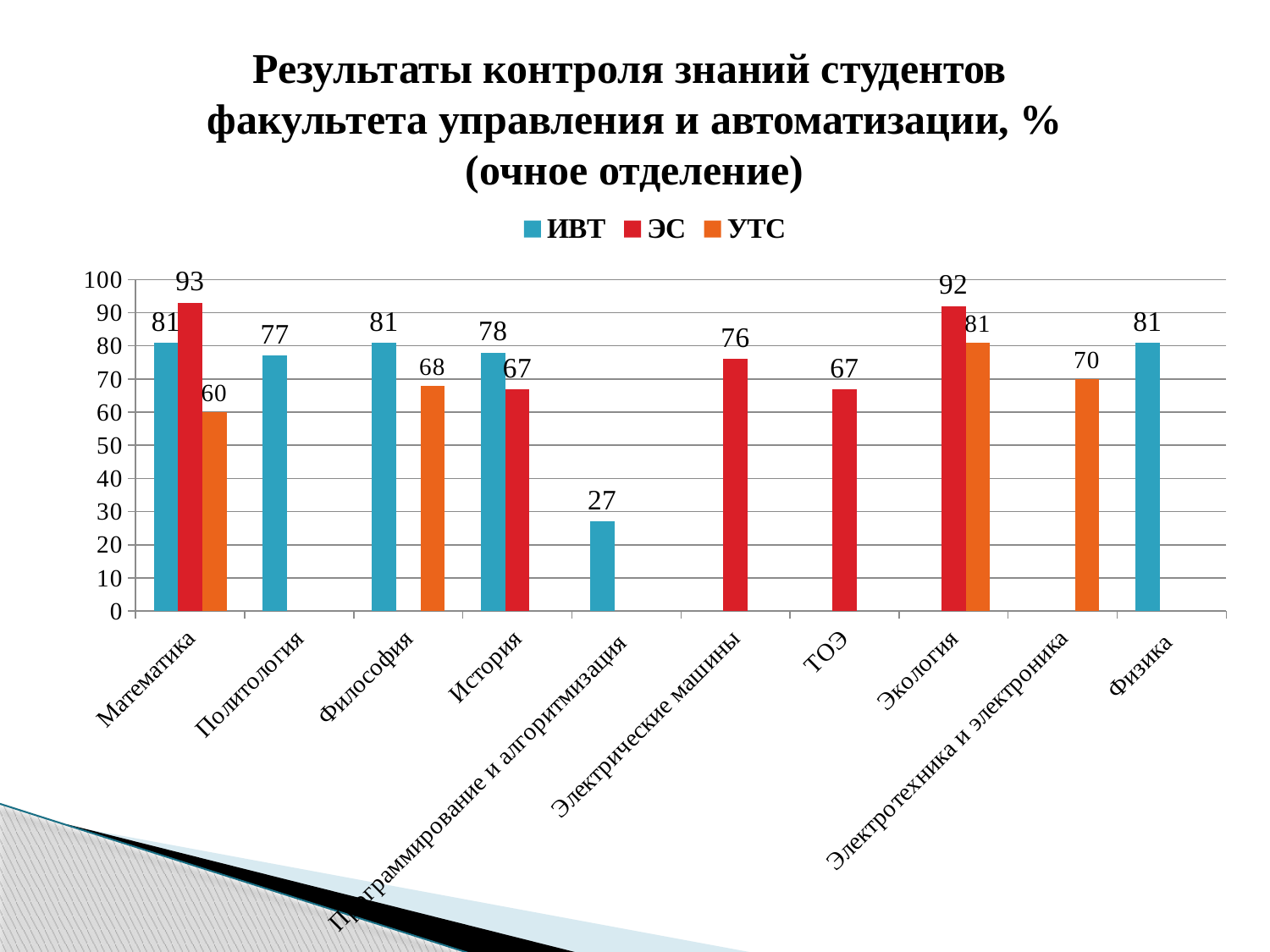
What is the value for ЭС in Экология? 92 How many series does the legend list? 3 What is the value for УТС in Философия? 68 How many categories are shown on the x axis? 10 Which category has the lowest ИВТ value? Программирование и алгоритмизация What is the value for ИВТ in Программирование и алгоритмизация? 27 What is the value for ЭС in Математика? 93 What kind of chart is shown on the slide? bar chart Which category has the highest ЭС value? Математика Which is larger: the ИВТ value in История or the ЭС value in История? ИВТ Which series is shown in orange in the legend? УТС What is the difference between the ЭС and УТС values in Математика? 33